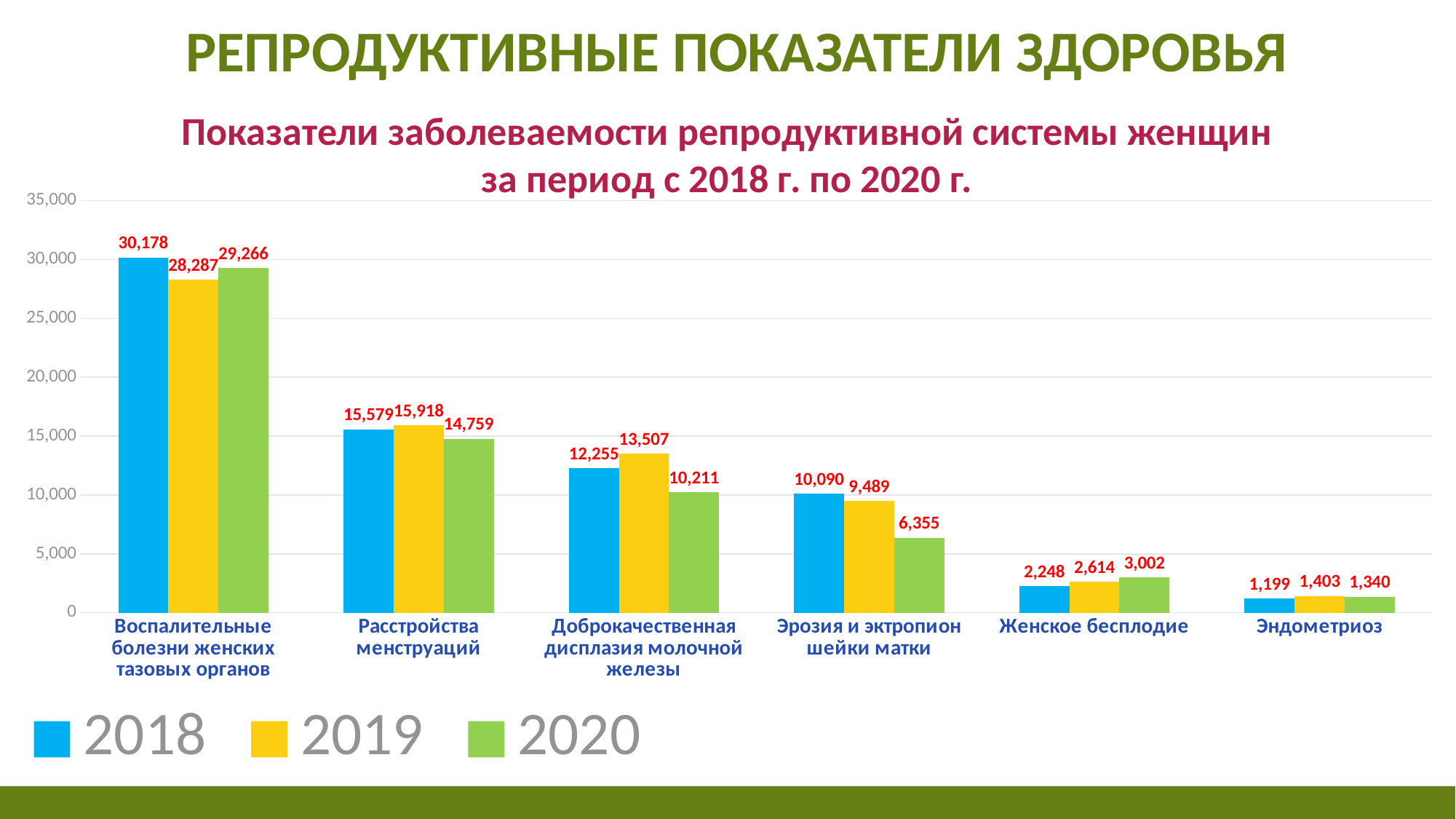
Which category has the lowest value in 2018? Эндометриоз What is the difference between the 2018 and 2020 values for Эрозия и эктропион шейки матки? 3,735 What is the value for Воспалительные болезни женских тазовых органов in 2018? 30,178 What is the difference between the 2018 and 2019 values for Воспалительные болезни женских тазовых органов? 1,891 How many series does the legend list? 3 Do the values for Женское бесплодие rise or fall from 2018 to 2020? Rise What kind of chart is shown on the slide? Bar chart What is the value for Женское бесплодие in 2019? 2,614 Which category has the highest value in 2020? Воспалительные болезни женских тазовых органов How many categories are shown on the x axis? 6 Which is larger for Доброкачественная дисплазия молочной железы: the 2019 value or the 2020 value? 2019 What is the value for Эрозия и эктропион шейки матки in 2020? 6,355